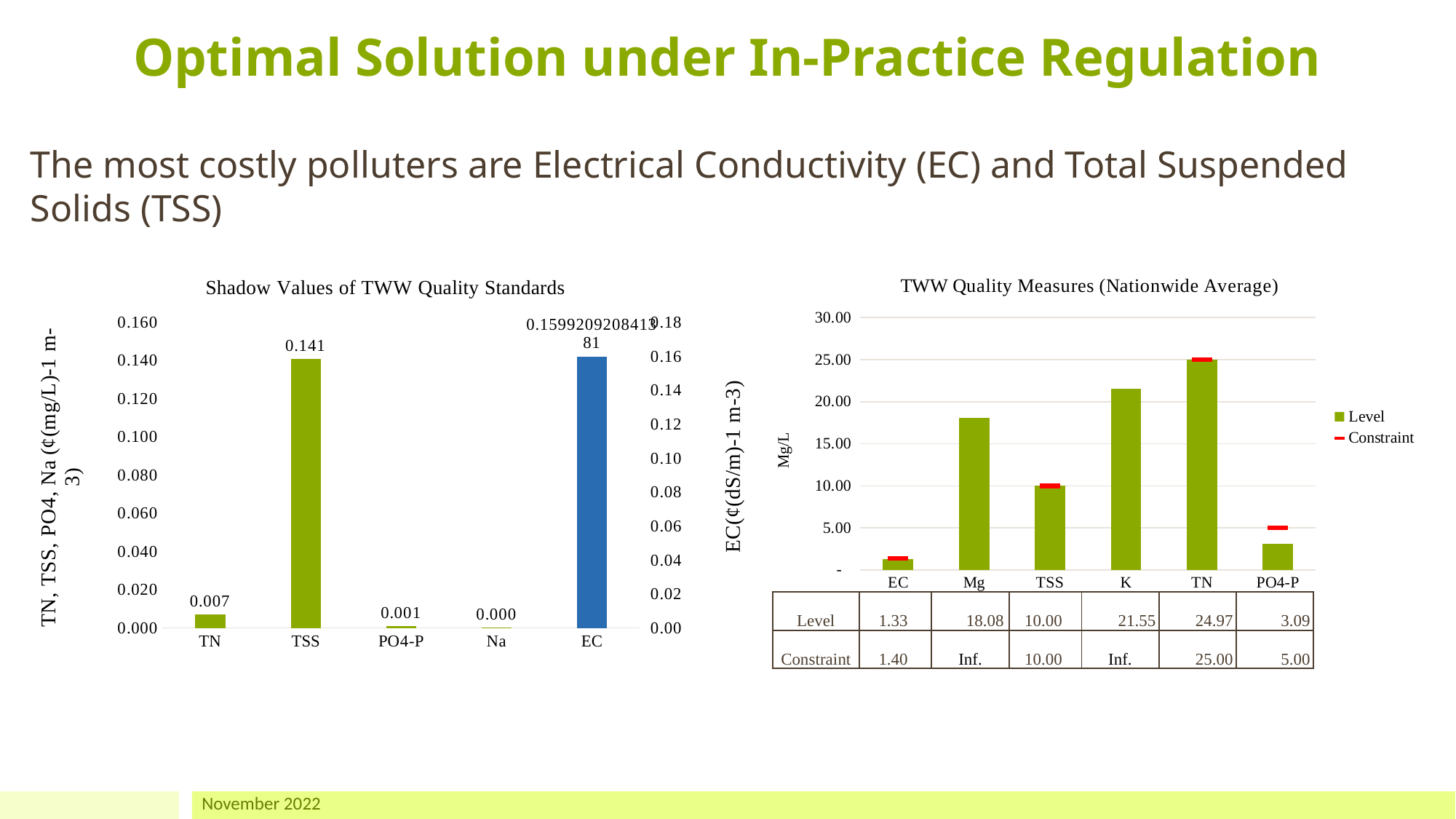
How many series does the legend of the 'TWW Quality Measures (Nationwide Average)' chart list? 2 In the 'Shadow Values of TWW Quality Standards' chart, which is larger, the value for PO4-P or the value for TN? TN In the 'TWW Quality Measures (Nationwide Average)' chart, what is the Level value for Mg? 18.08 In the 'Shadow Values of TWW Quality Standards' chart, what is the value for TN? 0.007 In the 'Shadow Values of TWW Quality Standards' chart, how many categories are shown on the x axis? 5 In the 'Shadow Values of TWW Quality Standards' chart, what is the value for TSS? 0.141 In the 'TWW Quality Measures (Nationwide Average)' chart, which category has the lowest Level value? EC In the 'Shadow Values of TWW Quality Standards' chart, what is the difference between the values for TSS and TN? 0.134 In the 'TWW Quality Measures (Nationwide Average)' chart, which category has the highest Level value? TN In the 'Shadow Values of TWW Quality Standards' chart, what is the value for Na? 0.000 In the 'TWW Quality Measures (Nationwide Average)' chart, what is the Constraint value for PO4-P? 5.00 What kind of chart is 'TWW Quality Measures (Nationwide Average)'? bar chart